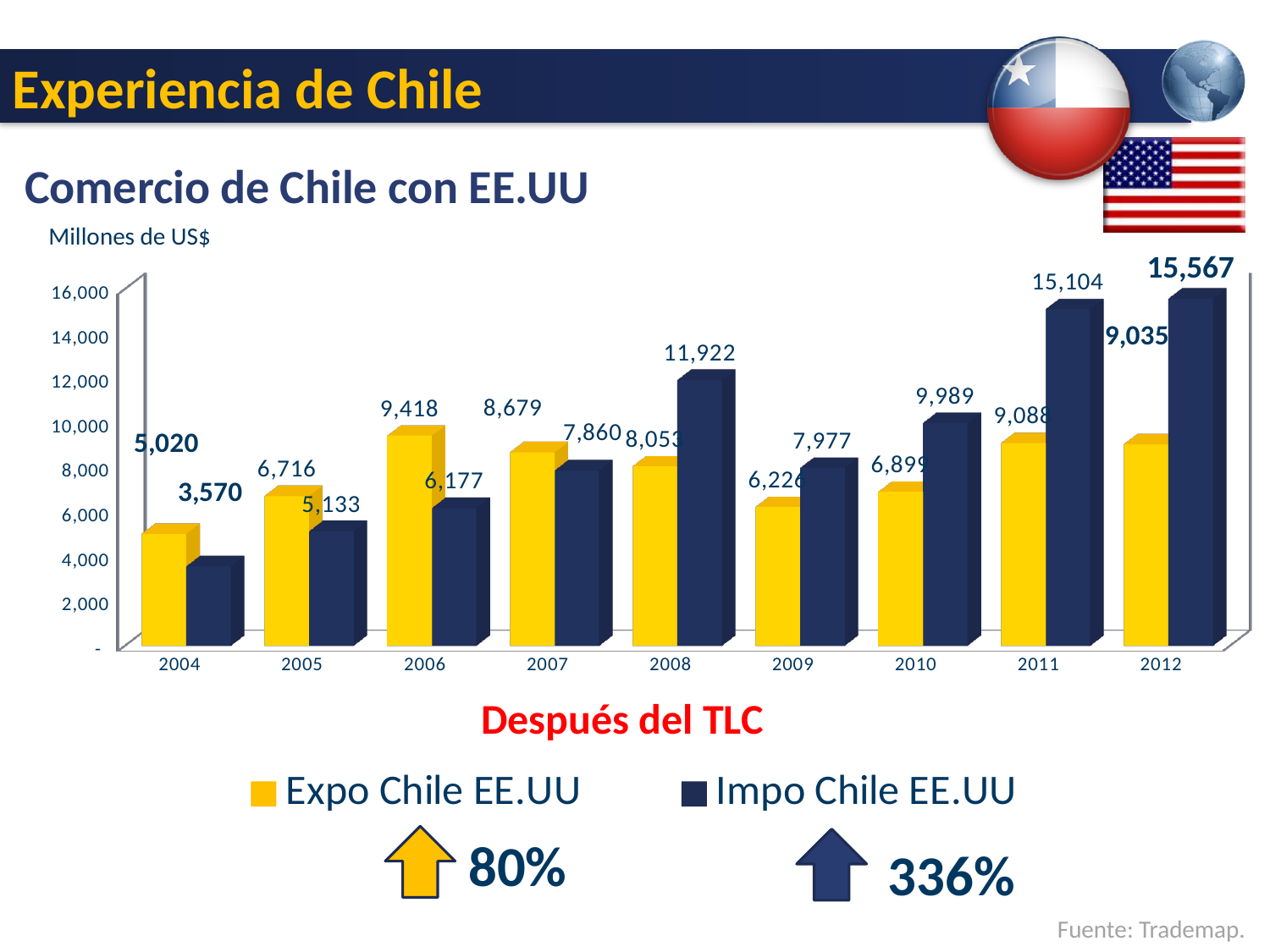
In which year is Impo Chile EE.UU highest? 2012 What is the value for Expo Chile EE.UU in 2009? 6,226 What kind of chart is shown on the slide? Bar chart How many series does the legend list? 2 What is the difference between Impo Chile EE.UU and Expo Chile EE.UU in 2012? 6,532 What is the value for Impo Chile EE.UU in 2012? 15,567 How many years are shown on the x axis? 9 In 2006, which is larger: Expo Chile EE.UU or Impo Chile EE.UU? Expo Chile EE.UU In which year is Impo Chile EE.UU lowest? 2004 What is the value for Impo Chile EE.UU in 2008? 11,922 What is the value for Expo Chile EE.UU in 2004? 5,020 In which year is Expo Chile EE.UU highest? 2006